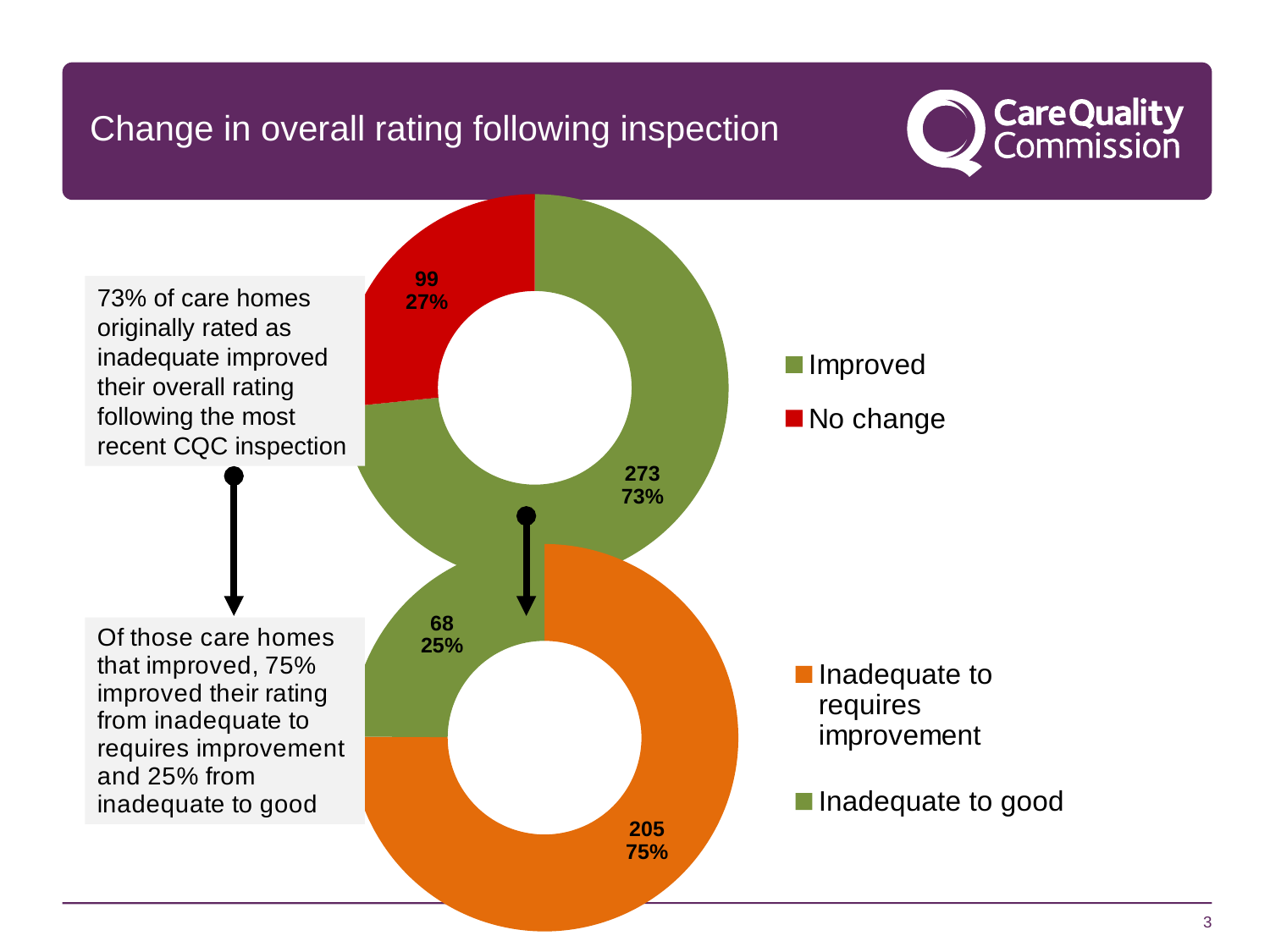
In the top doughnut chart, what percentage of care homes had 'No change'? 27% In the top doughnut chart, what is the total number of care homes across both categories? 372 What type of chart is used on this slide? Doughnut chart In the top doughnut chart, what is the difference in count between 'Improved' and 'No change'? 174 In the bottom doughnut chart, how many care homes moved from 'Inadequate to good'? 68 In the top doughnut chart, what colour represents 'No change'? Red In the bottom doughnut chart, what percentage of care homes moved from 'Inadequate to requires improvement'? 75% In the top doughnut chart, which category has the larger share? Improved In the bottom doughnut chart, what is the difference in count between 'Inadequate to requires improvement' and 'Inadequate to good'? 137 How many categories does the bottom doughnut chart show? 2 In the top doughnut chart, how many care homes are in the 'Improved' category? 273 In the bottom doughnut chart, which category has the smaller share? Inadequate to good